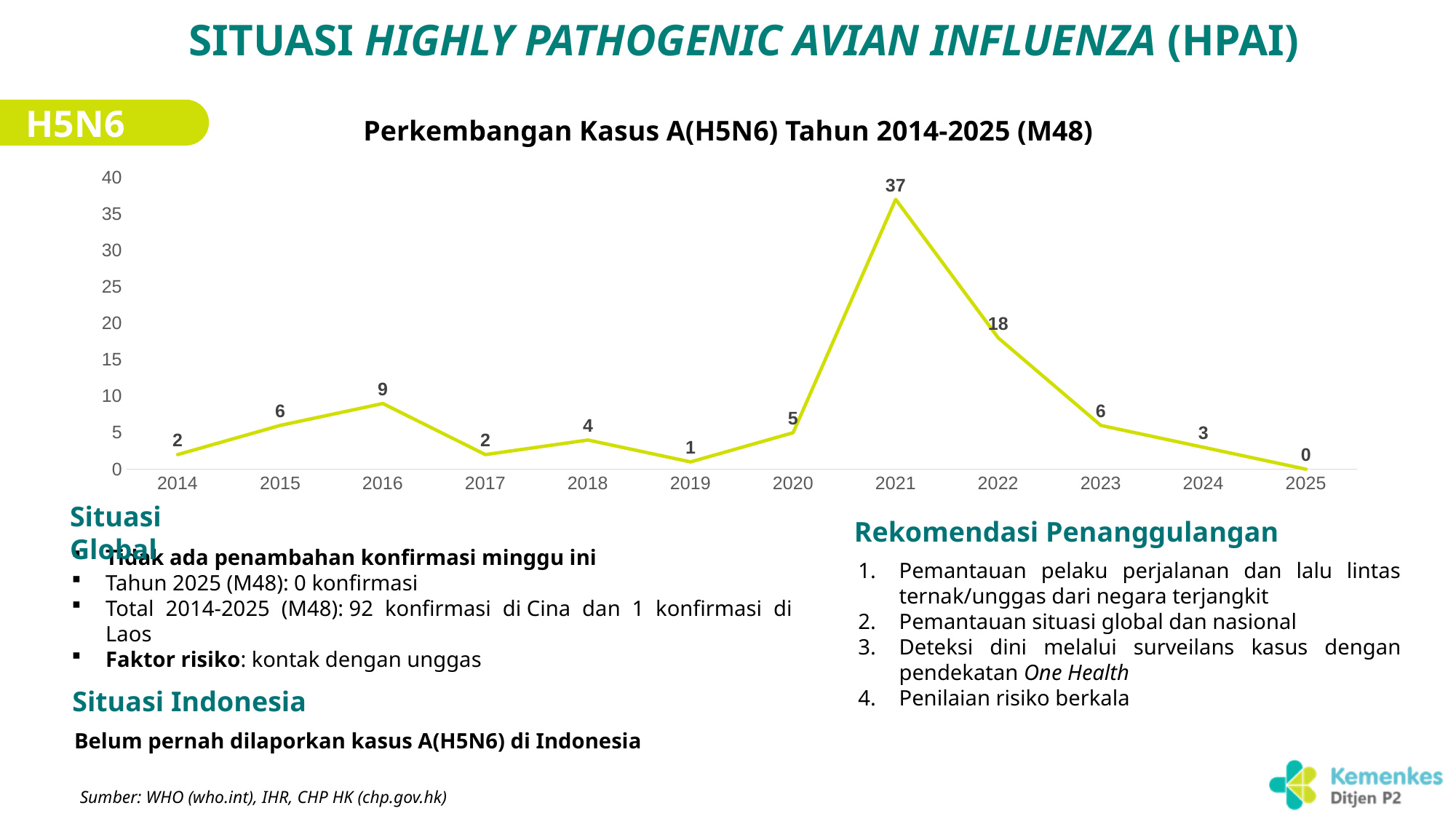
What is the value for 2016 in the A(H5N6) chart? 9 Which year has more cases, 2015 or 2023? They are equal (6 each) What type of chart is used to show the A(H5N6) cases for 2014-2025? Line chart Which year has more cases, 2018 or 2020? 2020 Which year has the lowest number of A(H5N6) cases? 2025 What is the difference between the number of cases in 2021 and 2022? 19 How many cases of A(H5N6) are shown for 2021? 37 What is the title of the chart on the slide? Perkembangan Kasus A(H5N6) Tahun 2014-2025 (M48) What is the value for 2025 in the A(H5N6) chart? 0 Do the A(H5N6) cases rise or fall from 2021 to 2025? Fall How many years are plotted on the A(H5N6) chart? 12 Which year has the highest number of A(H5N6) cases? 2021